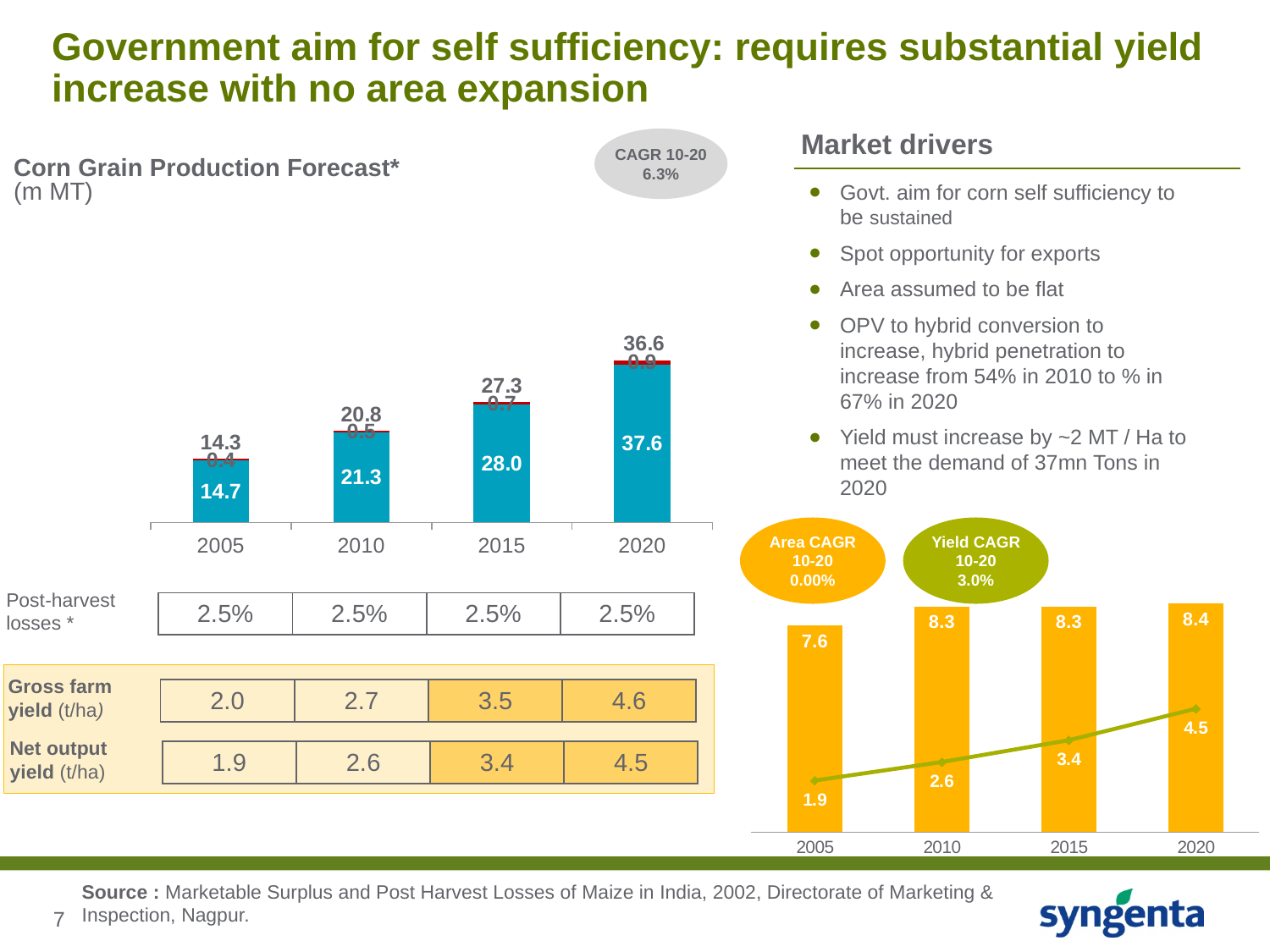
In the Corn Grain Production Forecast chart, what value is labelled inside the blue bar for 2005? 14.7 In the Corn Grain Production Forecast chart, which year has the highest bar? 2020 In the Corn Grain Production Forecast chart, which year has the lowest bar? 2005 In the Corn Grain Production Forecast chart, what is the difference between the blue bar values for 2020 and 2015? 9.6 In the Corn Grain Production Forecast chart, what total value is printed above the bar for 2015? 27.3 In the Corn Grain Production Forecast chart, do the bar values rise or fall from 2005 to 2020? rise In the bottom-right chart, what is the value labelled on the orange bar for 2005? 7.6 In the bottom-right chart, is the orange bar value for 2010 larger or smaller than the orange bar value for 2005? larger In the bottom-right chart, what is the value labelled on the line at 2015? 3.4 In the Corn Grain Production Forecast chart, what value is labelled inside the blue bar for 2020? 37.6 How many years are shown on the x axis of the Corn Grain Production Forecast chart? 4 What unit is given under the title of the Corn Grain Production Forecast chart? m MT